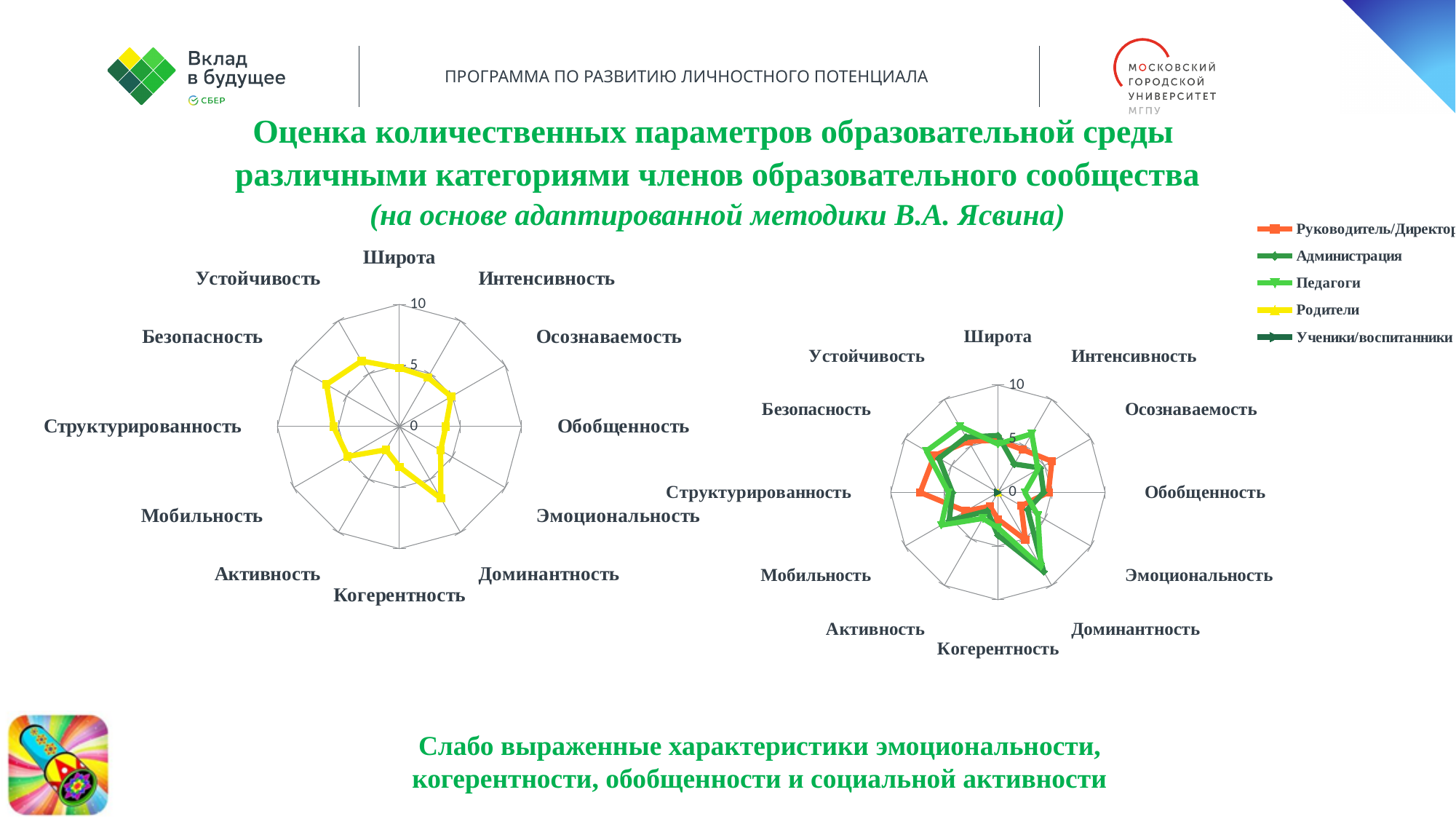
In the left radar chart, is the value for Доминантность greater or less than 5? greater In the left radar chart, is the value for Безопасность greater or less than 5? greater In the left radar chart, is the value for Широта greater or less than 10? less Which series is plotted in yellow according to the legend? Родители How many series does the legend on the slide list? 5 What kind of chart is the left chart on the slide? Radar chart How many categories (axes) does the left radar chart have? 12 What is the maximum value shown on the radial axis of the right radar chart? 10